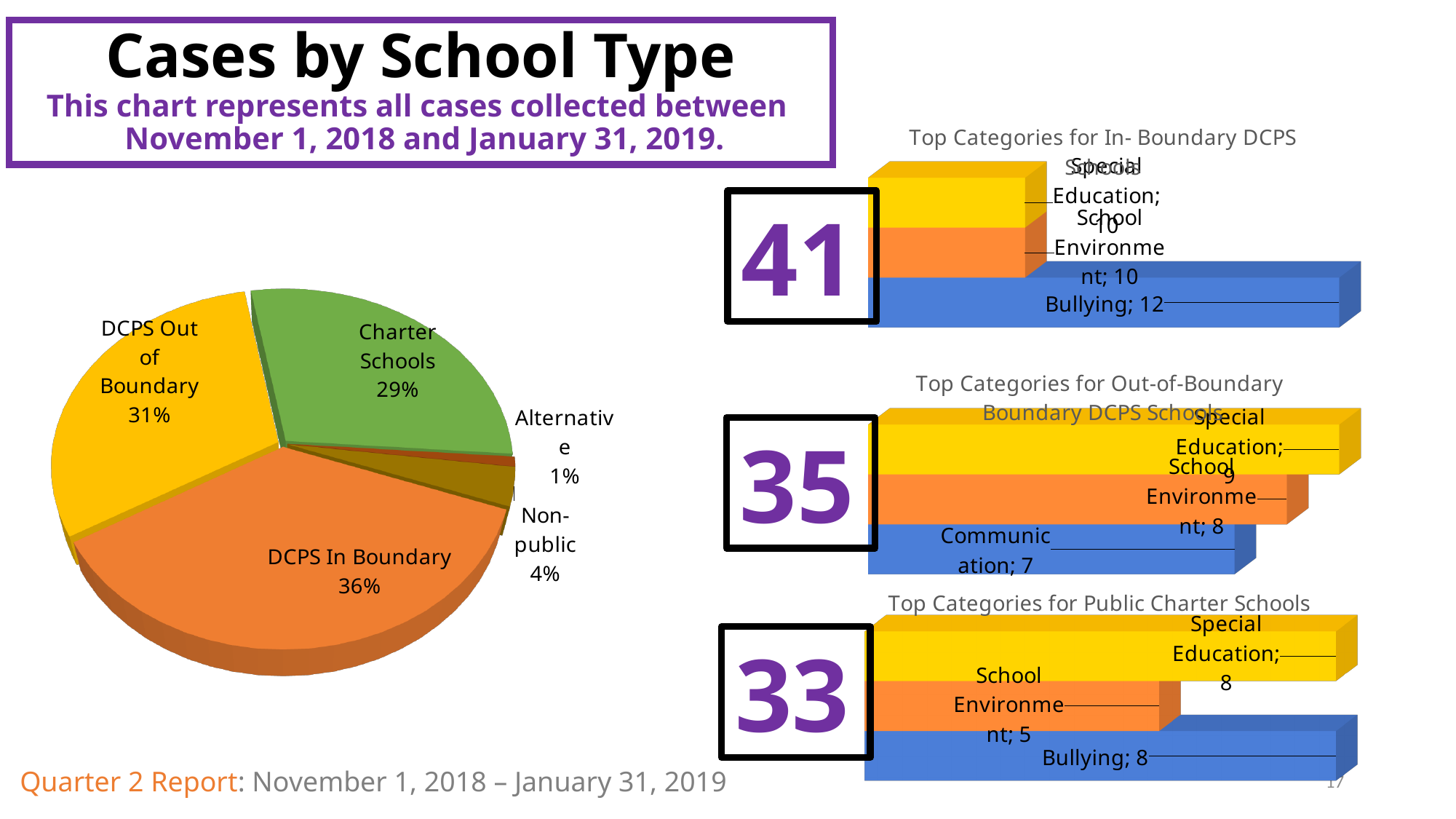
In the 'Top Categories for Public Charter Schools' chart, what is the value for School Environment? 5 In the pie chart on the left, how many school types (slices) are shown? 5 In the 'Top Categories for In-Boundary DCPS Schools' chart, which category has the highest value? Bullying What kind of chart is 'Top Categories for Public Charter Schools'? Bar chart In the pie chart on the left, which school type has the largest share of cases? DCPS In Boundary In the pie chart on the left, which school type has the smallest share of cases? Alternative What kind of chart is the chart on the left showing cases by school type? Pie chart In the pie chart on the left, what is the difference in percentage points between DCPS Out of Boundary and Charter Schools? 2 In the 'Top Categories for In-Boundary DCPS Schools' chart, what is the value for Bullying? 12 In the 'Top Categories for Out-of-Boundary DCPS Schools' chart, which is larger, Special Education or School Environment? Special Education In the 'Top Categories for Out-of-Boundary DCPS Schools' chart, what is the value for Communication? 7 In the pie chart on the left, what share of cases is DCPS In Boundary? 36%